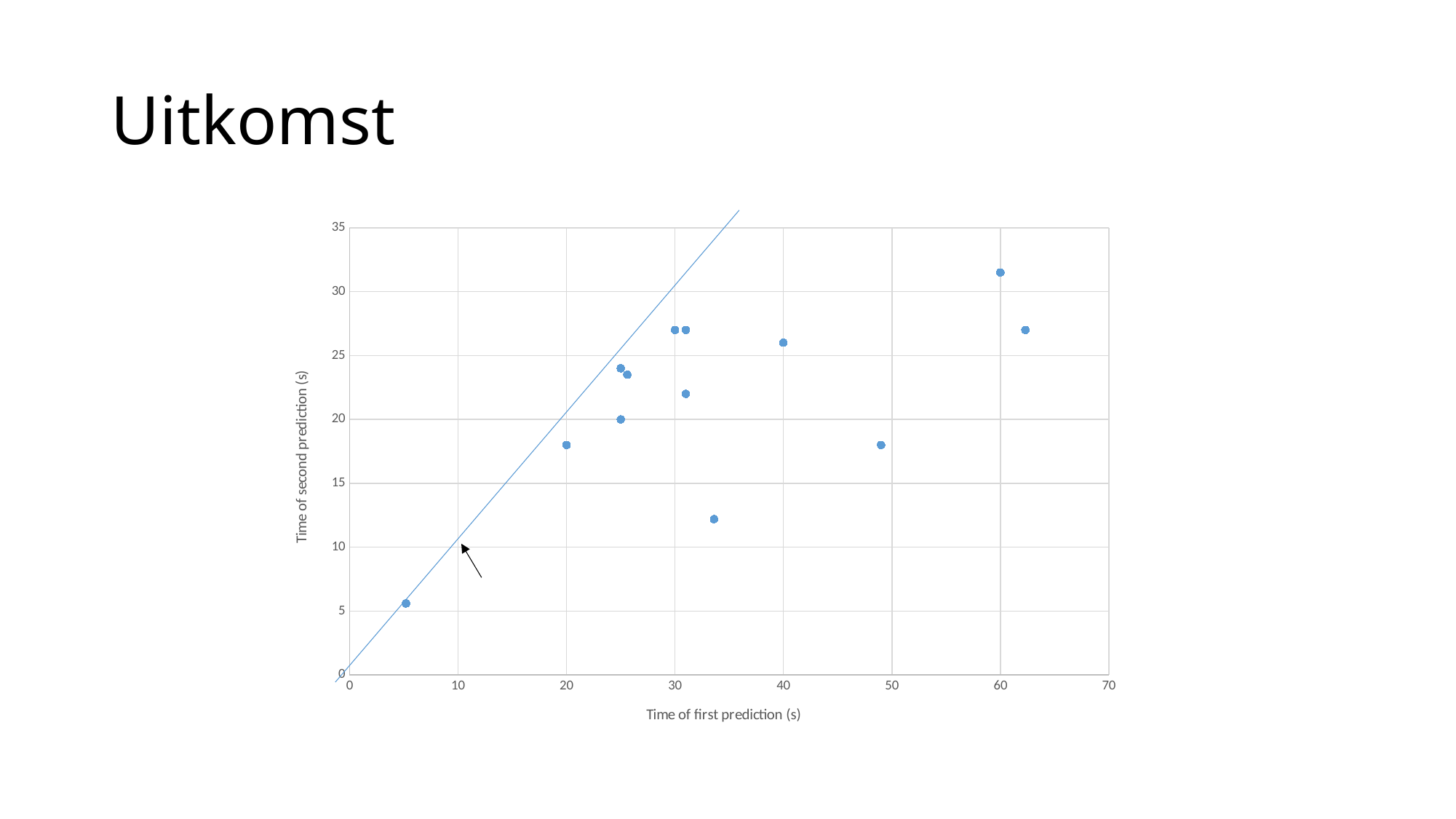
What is the title of the x axis of the chart? Time of first prediction (s) How many data points are plotted in the scatter chart? 13 Is the time of second prediction for the point with a first prediction time of about 49 s greater or less than 15? greater Is the time of second prediction for the point with a first prediction time of about 5 s greater or less than 10? less What kind of chart is shown on the slide? scatter chart Is the time of second prediction for the point with a first prediction time of about 60 s greater or less than 30? greater What is the title of the y axis of the chart? Time of second prediction (s) What is the maximum value shown on the y axis of the chart? 35 Which point has the lowest time of second prediction: the one at about 5 s or the one at about 33 s on the x axis? the one at about 5 s Which point has the highest time of second prediction: the one at about 60 s or the one at about 62 s on the x axis? the one at about 60 s